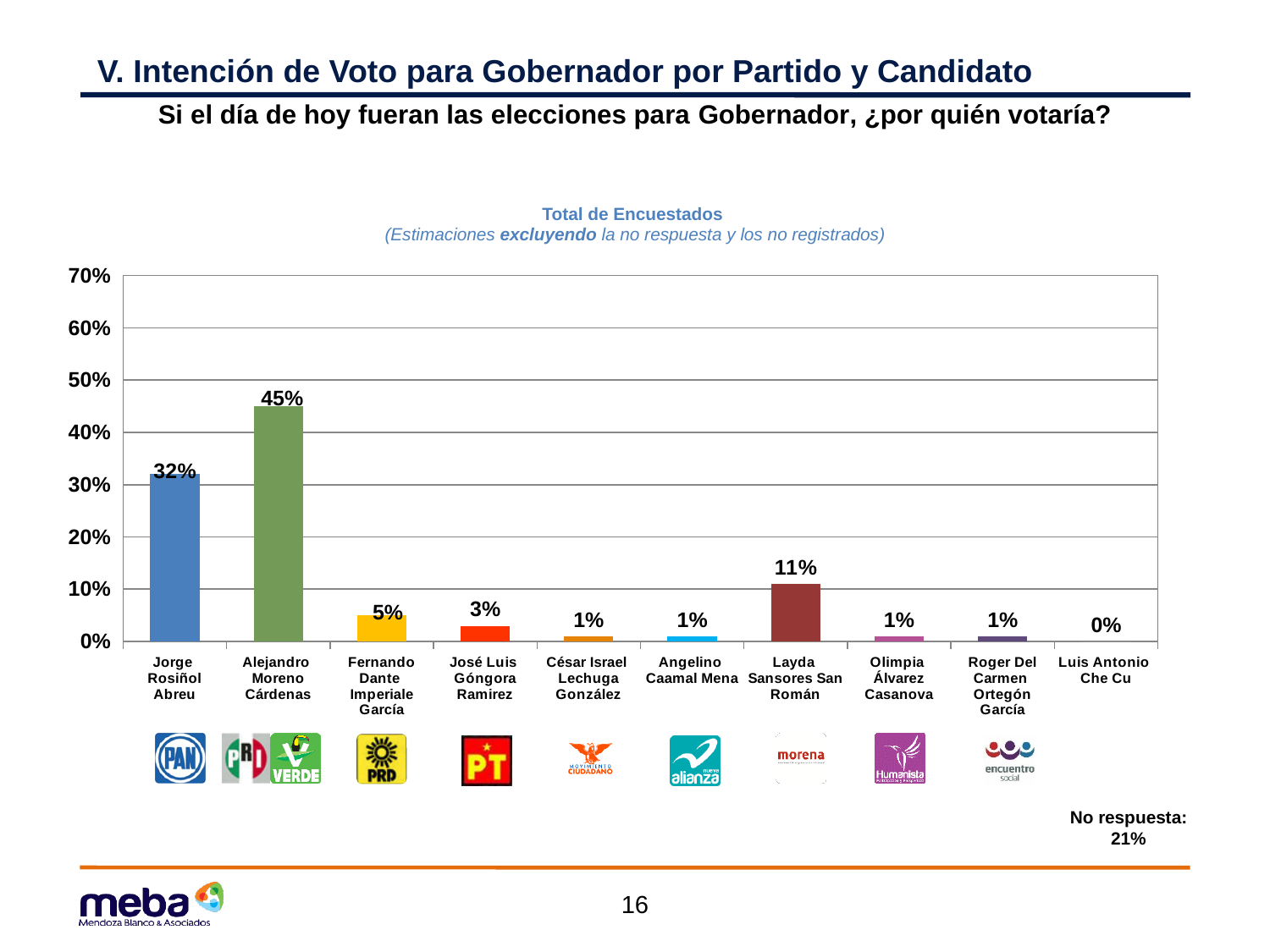
Who has a higher value, Layda Sansores San Román or José Luis Góngora Ramirez? Layda Sansores San Román How many candidates are shown on the x axis of the chart? 10 Which candidate has the lowest vote intention? Luis Antonio Che Cu What value is shown for Fernando Dante Imperiale García? 5% What is the 'No respuesta' percentage noted on the slide? 21% What is the difference between the values for Alejandro Moreno Cárdenas and Jorge Rosiñol Abreu? 13% Which candidate has the highest vote intention? Alejandro Moreno Cárdenas What percentage is shown for Layda Sansores San Román? 11% What is the value shown for Jorge Rosiñol Abreu? 32% What percentage of vote intention does Alejandro Moreno Cárdenas receive? 45% Is the value for Jorge Rosiñol Abreu greater or less than 30%? greater What type of chart is shown on the slide? Bar chart